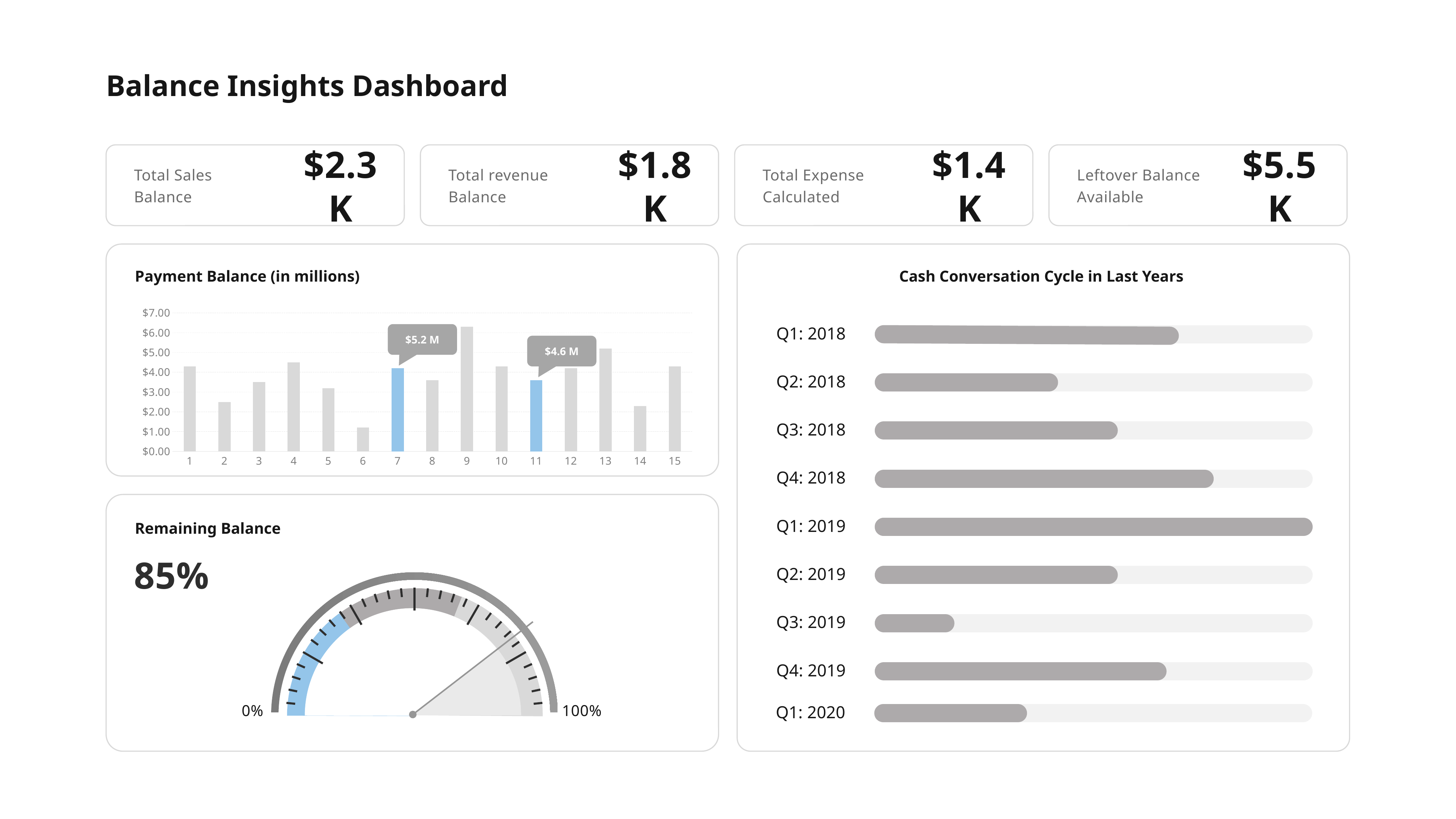
In the Payment Balance (in millions) chart, what data label is shown in the callout above bar 11? $4.6 M In the Payment Balance (in millions) chart, is the value for category 14 greater or less than $3.00? less In the Payment Balance (in millions) chart, which category has the lowest bar? 6 What type of chart is the Payment Balance (in millions) chart? bar chart In the Payment Balance (in millions) chart, is the value for category 6 greater or less than $2.00? less How many categories are listed in the Cash Conversation Cycle in Last Years chart? 9 In the Payment Balance (in millions) chart, which is larger, the bar for category 1 or the bar for category 2? 1 In the Payment Balance (in millions) chart, what data label is shown in the callout above bar 7? $5.2 M How many categories are shown on the x axis of the Payment Balance (in millions) chart? 15 In the Payment Balance (in millions) chart, which category has the highest bar? 9 In the Cash Conversation Cycle in Last Years chart, which quarter has the shortest bar? Q3: 2019 In the Cash Conversation Cycle in Last Years chart, which quarter has the longest bar? Q1: 2019